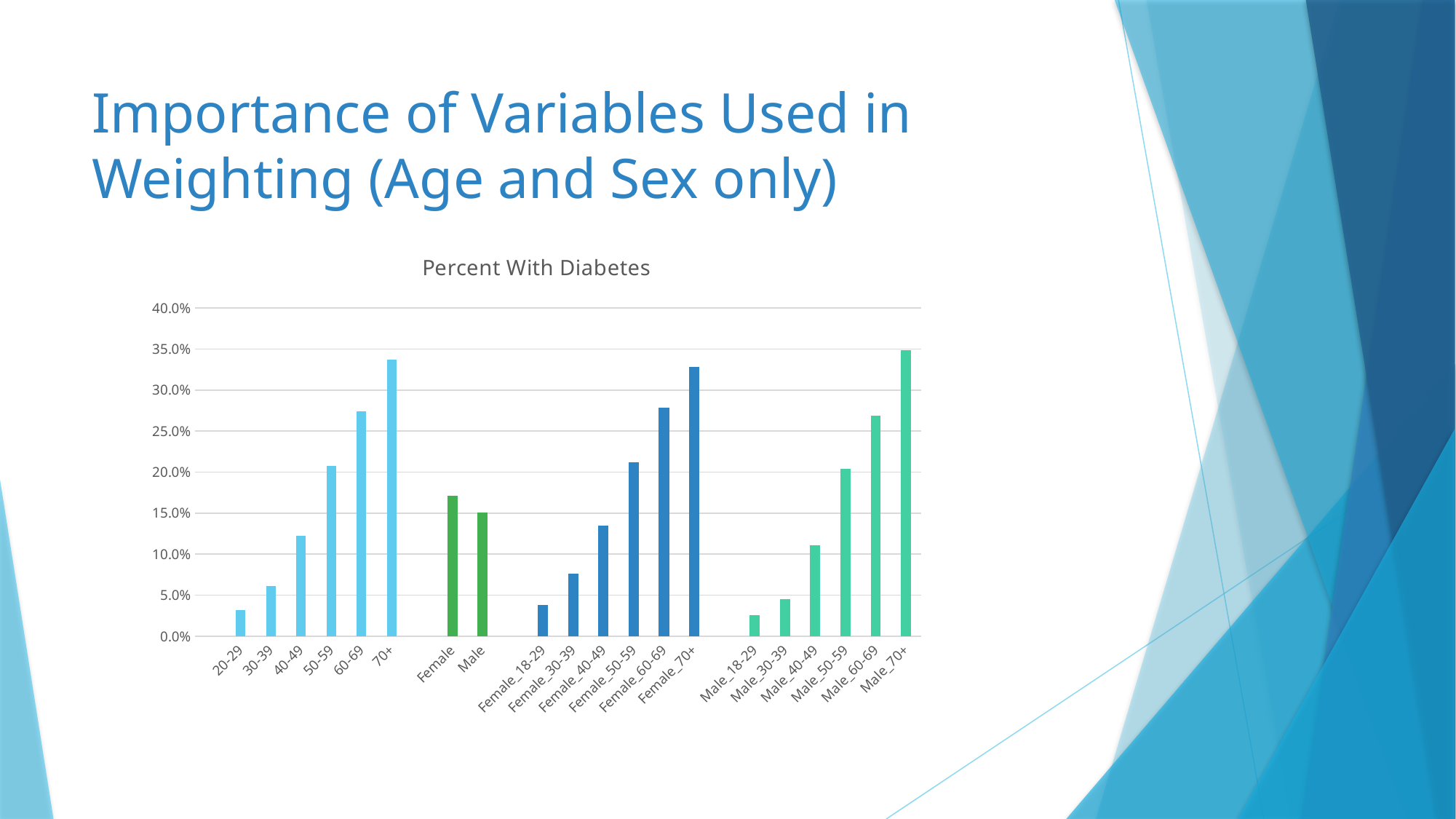
Which is larger, the value for Female_18-29 or the value for Male_18-29? Female_18-29 Is the value for Female greater or less than 15.0%? greater Do the values rise or fall across the age groups from 20-29 to 70+? Rise Is the value for Female_50-59 greater or less than 20.0%? greater How many categories are plotted along the x axis of the chart? 20 What is the title of the chart? Percent With Diabetes Is the value for 70+ greater or less than 30.0%? greater Among the Female_ age-group categories, which has the highest value? Female_70+ What kind of chart is shown on the slide? Bar chart Which is larger, the value for Female or the value for Male? Female